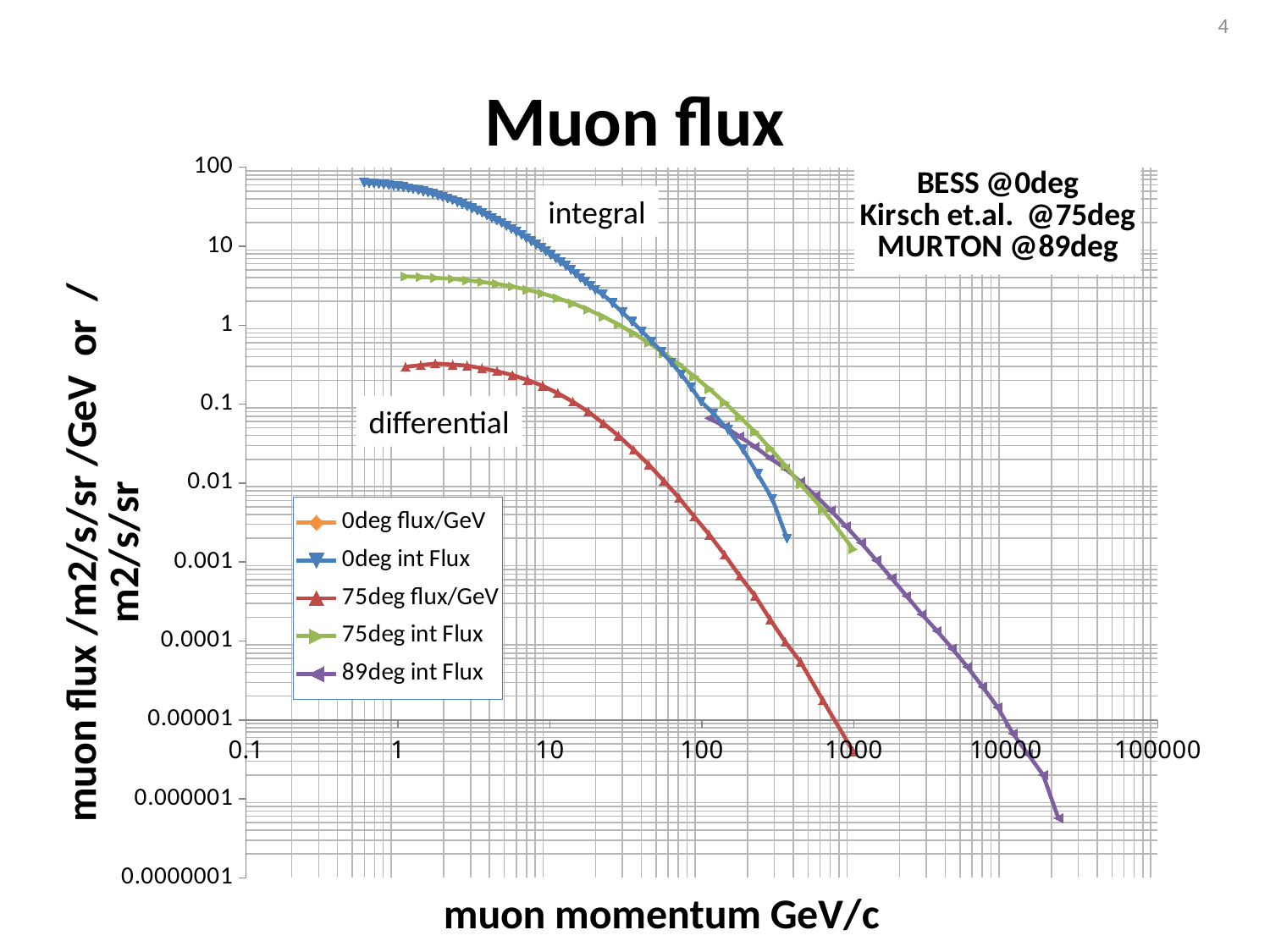
Is the value of the 0deg int Flux series at a momentum of 1 GeV/c greater or less than 10? greater Is the value of the 89deg int Flux series at a momentum of 1000 GeV/c greater or less than 0.01? less How many series does the legend list? 5 Do the plotted flux values rise or fall as muon momentum increases? fall What kind of chart is shown on the slide? line chart What is the title of the chart? BESS @0deg Kirsch et.al. @75deg MURTON @89deg Which series extends to the highest muon momentum on the chart? 89deg int Flux What is the label of the x axis? muon momentum GeV/c At a momentum of 1 GeV/c, which is larger: the 0deg int Flux or the 75deg int Flux? 0deg int Flux Is the value of the 75deg flux/GeV series at a momentum of 1 GeV/c greater or less than 1? less Which series reaches the highest flux value on the chart? 0deg int Flux